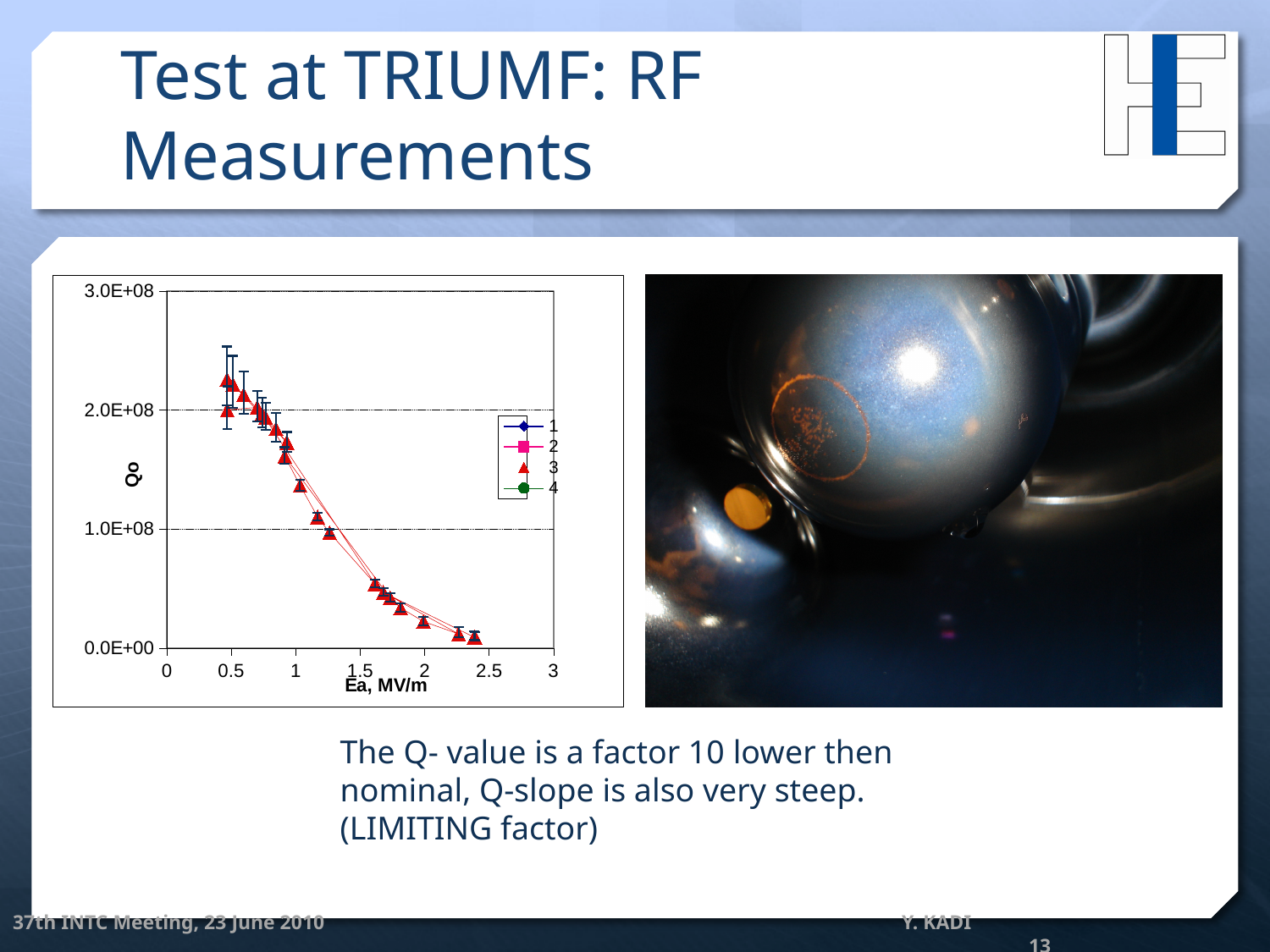
Does Qo rise or fall as Ea increases along the x axis? fall Is the Qo value at Ea of about 1.5 MV/m greater or less than 1.0E+08? less What is the label of the x axis of the chart? Ea, MV/m Is the Qo value at Ea of about 2 MV/m greater or less than 1.0E+08? less Is the Qo value at Ea of about 1 MV/m greater or less than 1.0E+08? greater What is the highest tick value shown on the y axis of the chart? 3.0E+08 What are the legend entries of the chart? 1, 2, 3, 4 How many series does the chart legend list? 4